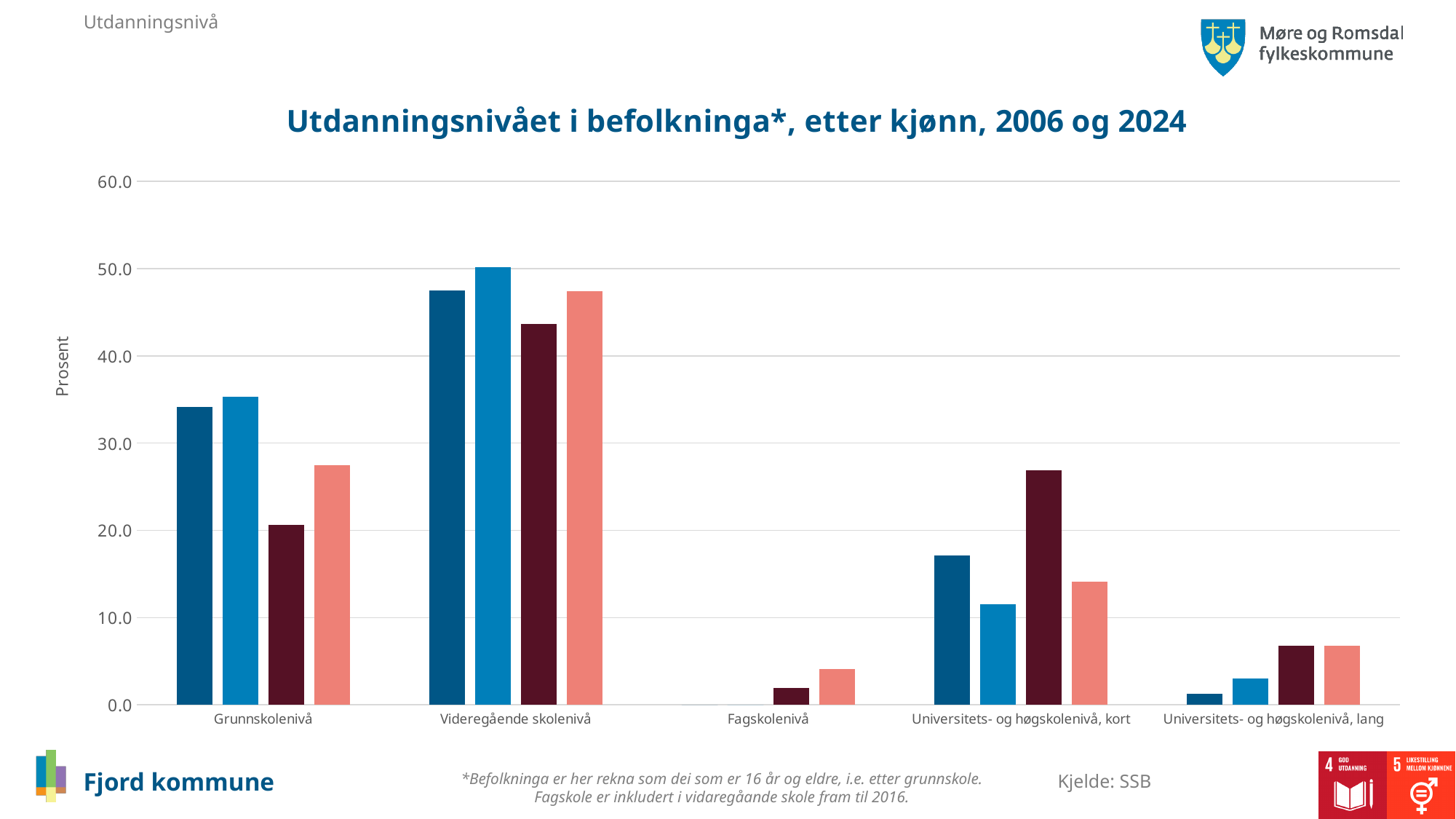
For Grunnskolenivå, which is larger: the dark red bar or the salmon-coloured bar? the salmon-coloured bar Is the value of the dark red bar for Universitets- og høgskolenivå, kort greater or less than 20? greater Is the value of the first (dark blue) bar for Grunnskolenivå greater or less than 30? greater What kind of chart is shown on the slide? bar chart Is the value of the salmon-coloured bar for Fagskolenivå greater or less than 10? less How many education-level categories are shown on the x axis? 5 What is the title of the chart? Utdanningsnivået i befolkninga*, etter kjønn, 2006 og 2024 Which category has the tallest bars overall? Videregående skolenivå For Universitets- og høgskolenivå, kort, which is larger: the light blue bar or the dark red bar? the dark red bar Which category has the lowest bars overall? Fagskolenivå